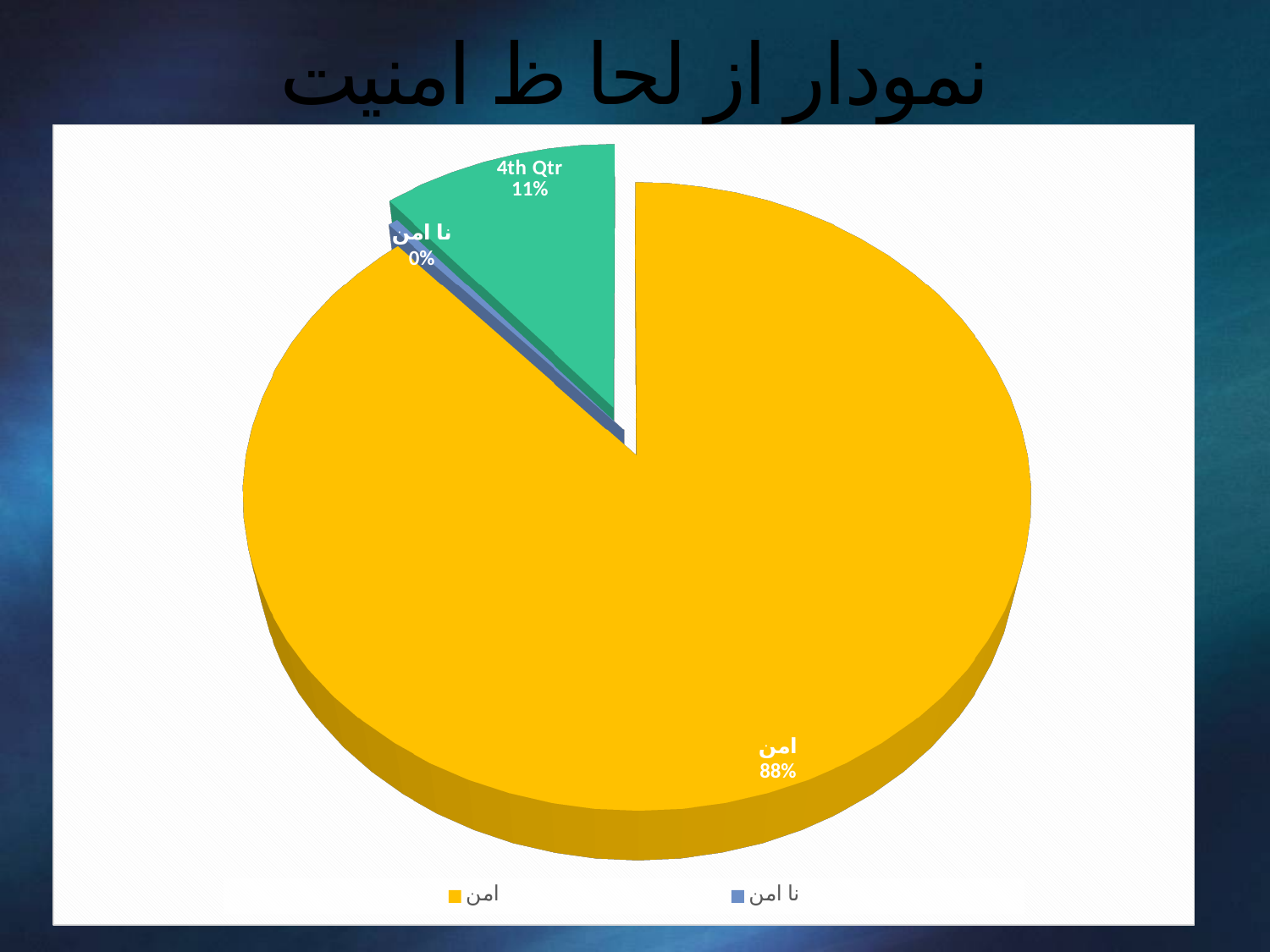
What share of the pie does the slice labelled 4th Qtr have? 11% What kind of chart is shown on the slide? Pie chart Which slice is larger, 4th Qtr or نا امن? 4th Qtr What colour is the slice labelled 4th Qtr? Green How many entries does the legend list? 2 How many slices are labelled on the pie chart? 3 Which slice of the pie is the smallest? نا امن What share of the pie does the slice labelled امن have? 88% What is the difference in percentage points between the امن slice and the 4th Qtr slice? 77 Which slice of the pie is the largest? امن What is the title of the slide? نمودار از لحاظ امنیت What share of the pie does the slice labelled نا امن have? 0%